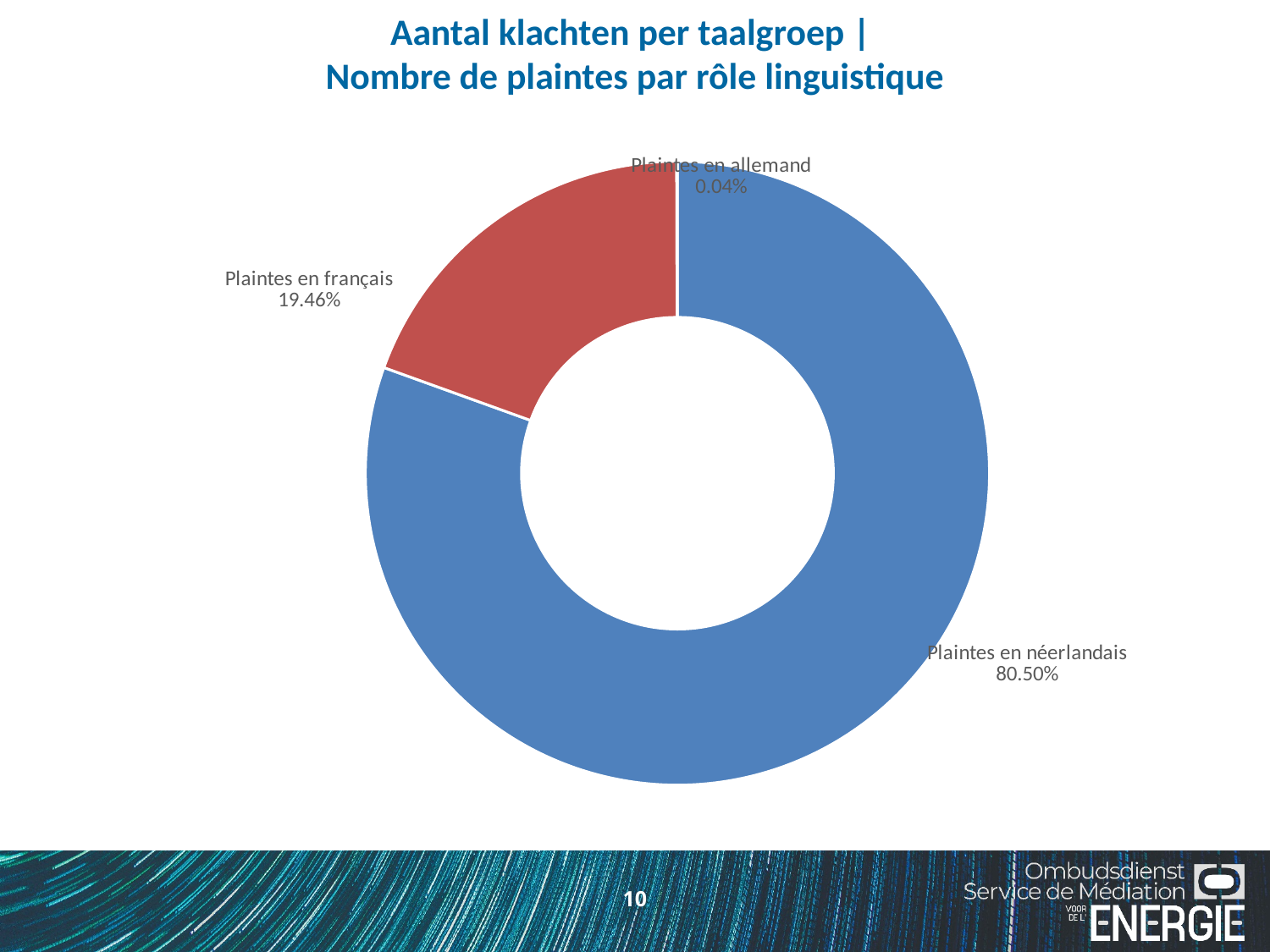
What is the difference in percentage points between Plaintes en néerlandais and Plaintes en français? 61.04% What colour is the slice for Plaintes en français? Red What kind of chart is shown on the slide? Doughnut (pie) chart What is the title of the chart? Aantal klachten per taalgroep | Nombre de plaintes par rôle linguistique What share of complaints is labelled for Plaintes en français? 19.46% How many language groups are shown in the chart? 3 Which is larger, the share for Plaintes en français or the share for Plaintes en allemand? Plaintes en français Which language group has the largest share of complaints? Plaintes en néerlandais Which language group has the smallest share of complaints? Plaintes en allemand What share of complaints is labelled for Plaintes en néerlandais? 80.50% What share of complaints is labelled for Plaintes en allemand? 0.04%